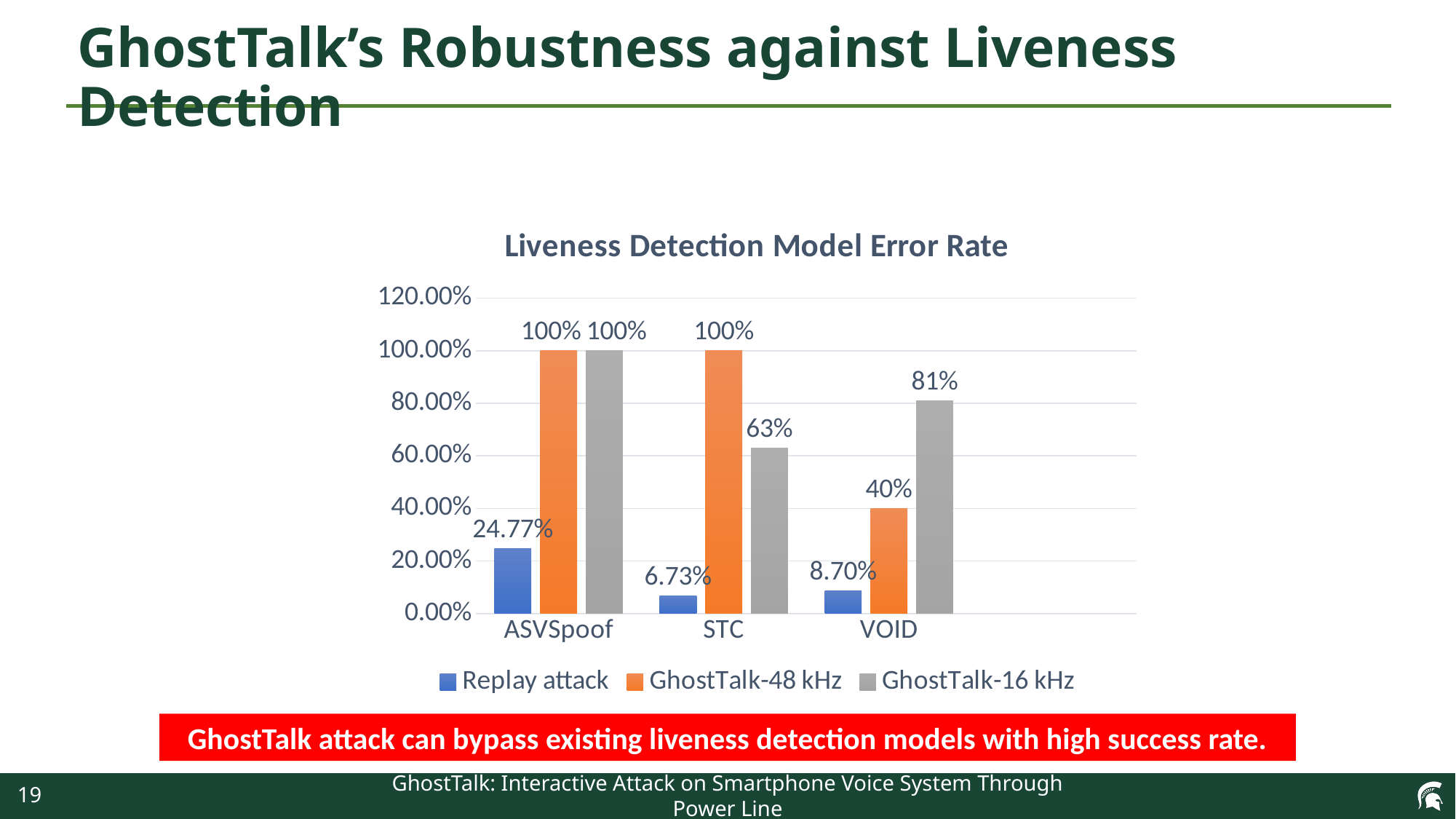
Which liveness detection model has the lowest Replay attack error rate? STC What is the error rate for Replay attack on STC? 6.73% What is the difference between the GhostTalk-16 kHz and GhostTalk-48 kHz error rates on VOID? 41% What is the error rate for GhostTalk-16 kHz on VOID? 81% What is the error rate for Replay attack on ASVSpoof? 24.77% How many series does the legend list? 3 What is the error rate for GhostTalk-16 kHz on STC? 63% How many liveness detection models are shown on the x axis? 3 What type of chart is shown on the slide? Bar chart What is the error rate for GhostTalk-48 kHz on VOID? 40% Which liveness detection model has the lowest GhostTalk-48 kHz error rate? VOID On STC, which is larger: the GhostTalk-48 kHz error rate or the GhostTalk-16 kHz error rate? GhostTalk-48 kHz